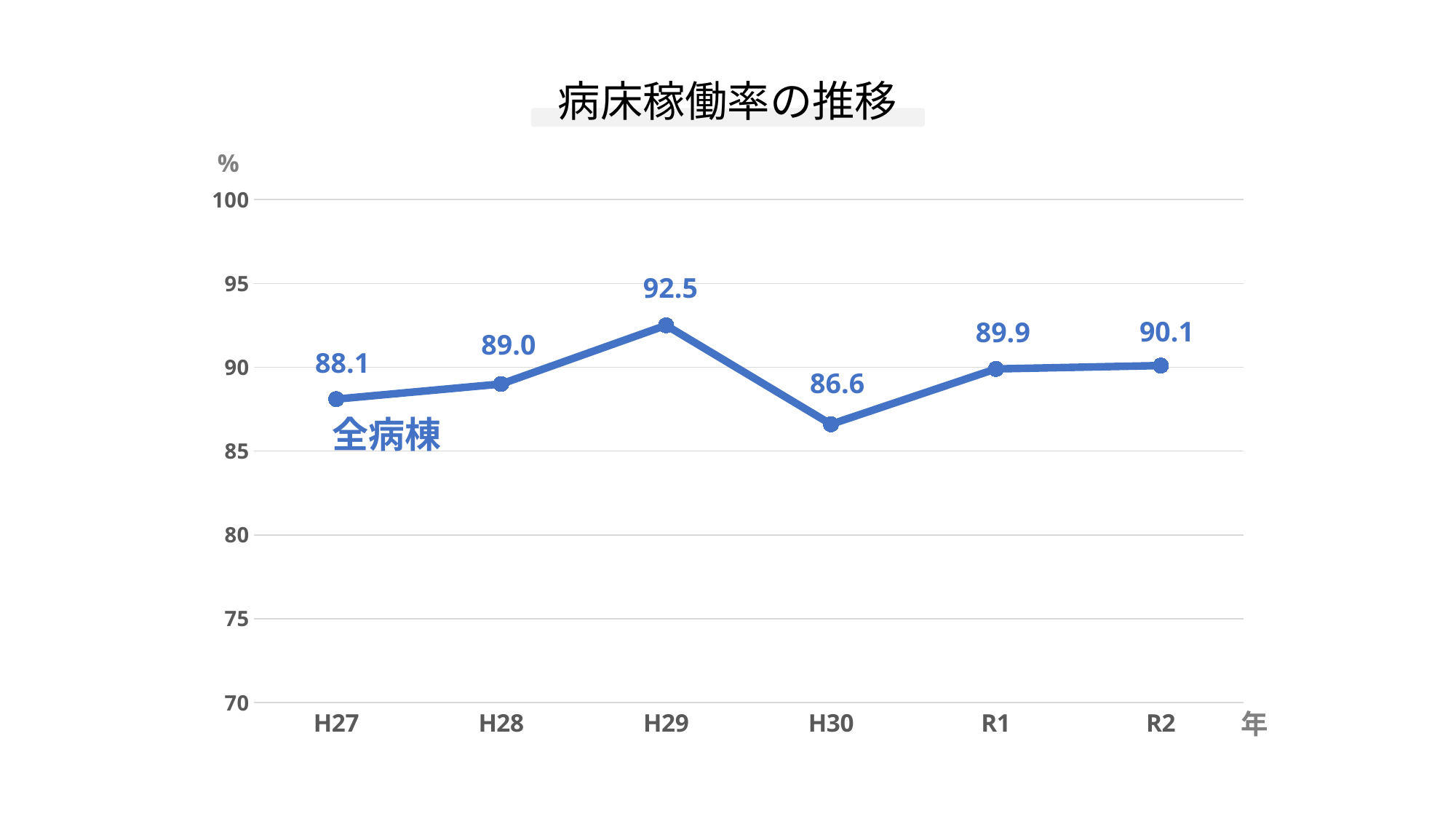
Which year has the highest bed occupancy rate? H29 How many years are plotted on the x axis? 6 What is the bed occupancy rate for H29? 92.5 What is the value for R2? 90.1 Which is larger, the value for H27 or the value for H28? H28 Is the value for H29 greater or less than 90? greater What is the value for H30? 86.6 Does the value rise or fall from H29 to H30? fall What is the difference between the values for H29 and H30? 5.9 What kind of chart is shown? line chart What is the title of the chart? 病床稼働率の推移 Which year has the lowest bed occupancy rate? H30